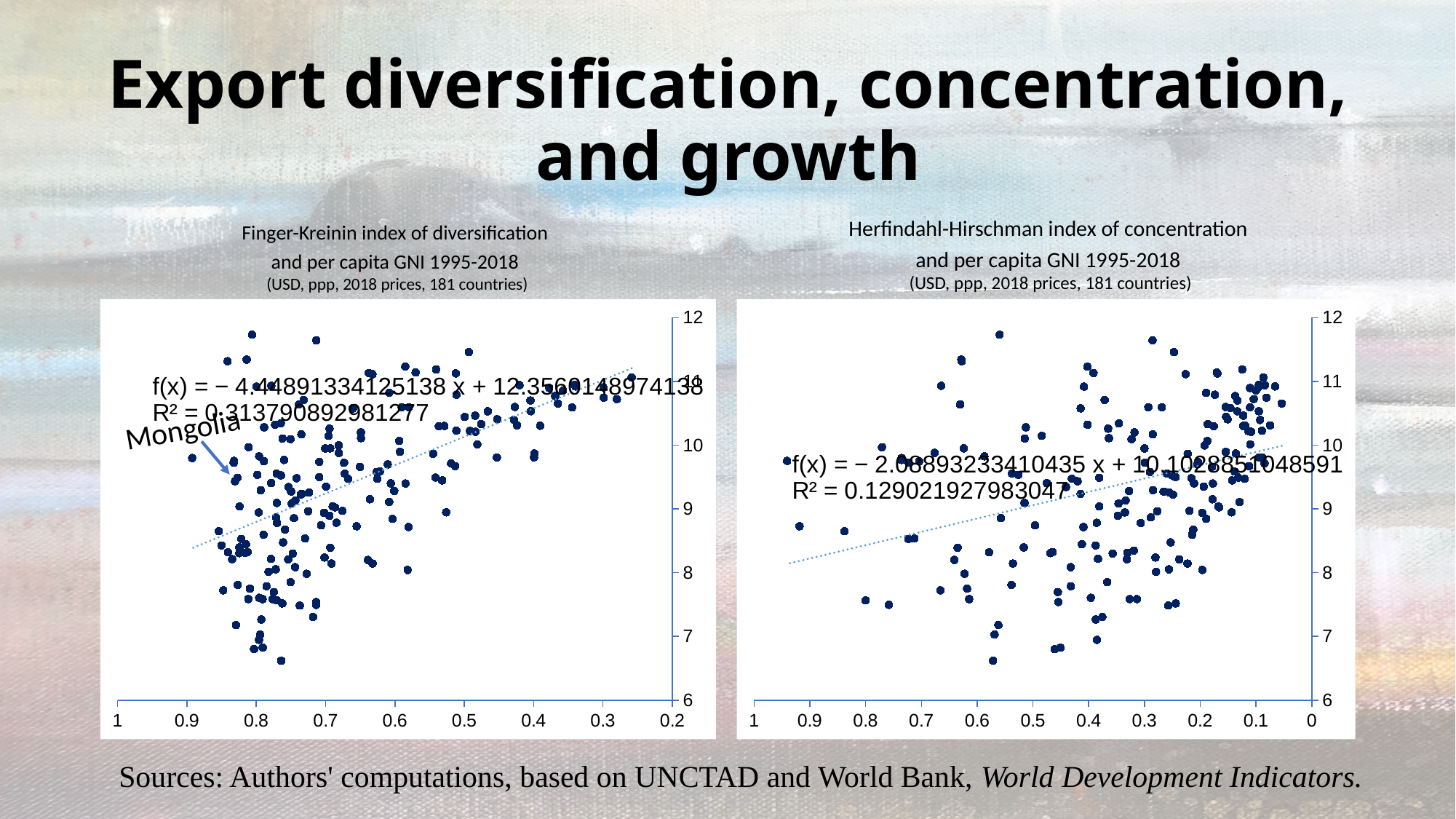
In the left chart (Finger-Kreinin index of diversification), what is the trendline equation shown? f(x) = − 4.44891334125138 x + 12.3560148974138 In the left chart (Finger-Kreinin index of diversification), is the y-axis value of the point labelled Mongolia greater or less than 9? greater What kind of chart is the left chart, titled 'Finger-Kreinin index of diversification and per capita GNI 1995-2018'? Scatter plot In the right chart (Herfindahl-Hirschman index of concentration), what is the R² value shown for the trendline? 0.129021927983047 Which chart has the higher R² value, the left chart (Finger-Kreinin index) or the right chart (Herfindahl-Hirschman index)? The left chart (Finger-Kreinin index) What kind of chart is the right chart, titled 'Herfindahl-Hirschman index of concentration and per capita GNI 1995-2018'? Scatter plot In the left chart (Finger-Kreinin index of diversification), what is the R² value shown for the trendline? 0.313790892981277 How many countries does each chart's title say are included? 181 What is the range of the vertical axis on both charts? 6 to 12 In the right chart (Herfindahl-Hirschman index of concentration), what is the trendline equation shown? f(x) = − 2.08893233410435 x + 10.1028851048591 In the left chart (Finger-Kreinin index of diversification), which country is labelled with an arrow? Mongolia In the right chart (Herfindahl-Hirschman index of concentration), does the dotted trendline rise or fall from left to right? Rise